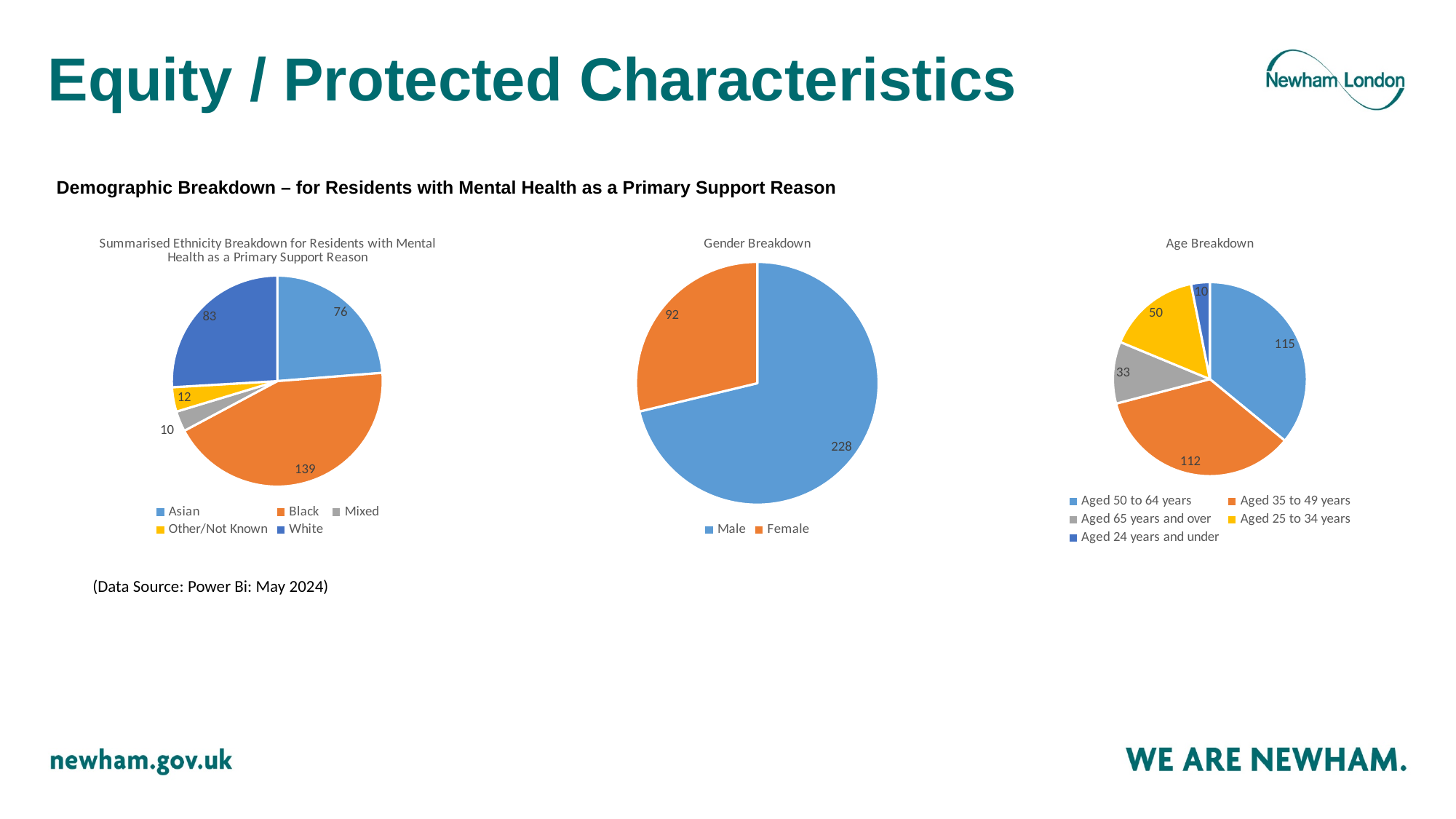
In the Gender Breakdown pie chart, what share of the total does the Male slice represent? 71.25% In the Gender Breakdown pie chart, what is the difference between the Male and Female values? 136 In the Age Breakdown pie chart, what is the value for Aged 25 to 34 years? 50 In the Age Breakdown pie chart, which age group has the largest value? Aged 50 to 64 years In the Age Breakdown pie chart, what is the total of all the slices? 320 In the Summarised Ethnicity Breakdown pie chart, which is larger, the value for White or the value for Asian? White How many categories does the Age Breakdown pie chart show? 5 What type of chart is the Gender Breakdown chart? Pie chart In the Summarised Ethnicity Breakdown pie chart, what colour is the Other/Not Known slice? Yellow In the Summarised Ethnicity Breakdown pie chart, which category has the smallest value? Mixed In the Summarised Ethnicity Breakdown pie chart, what is the value for Black? 139 In the Gender Breakdown pie chart, what is the value for Male? 228